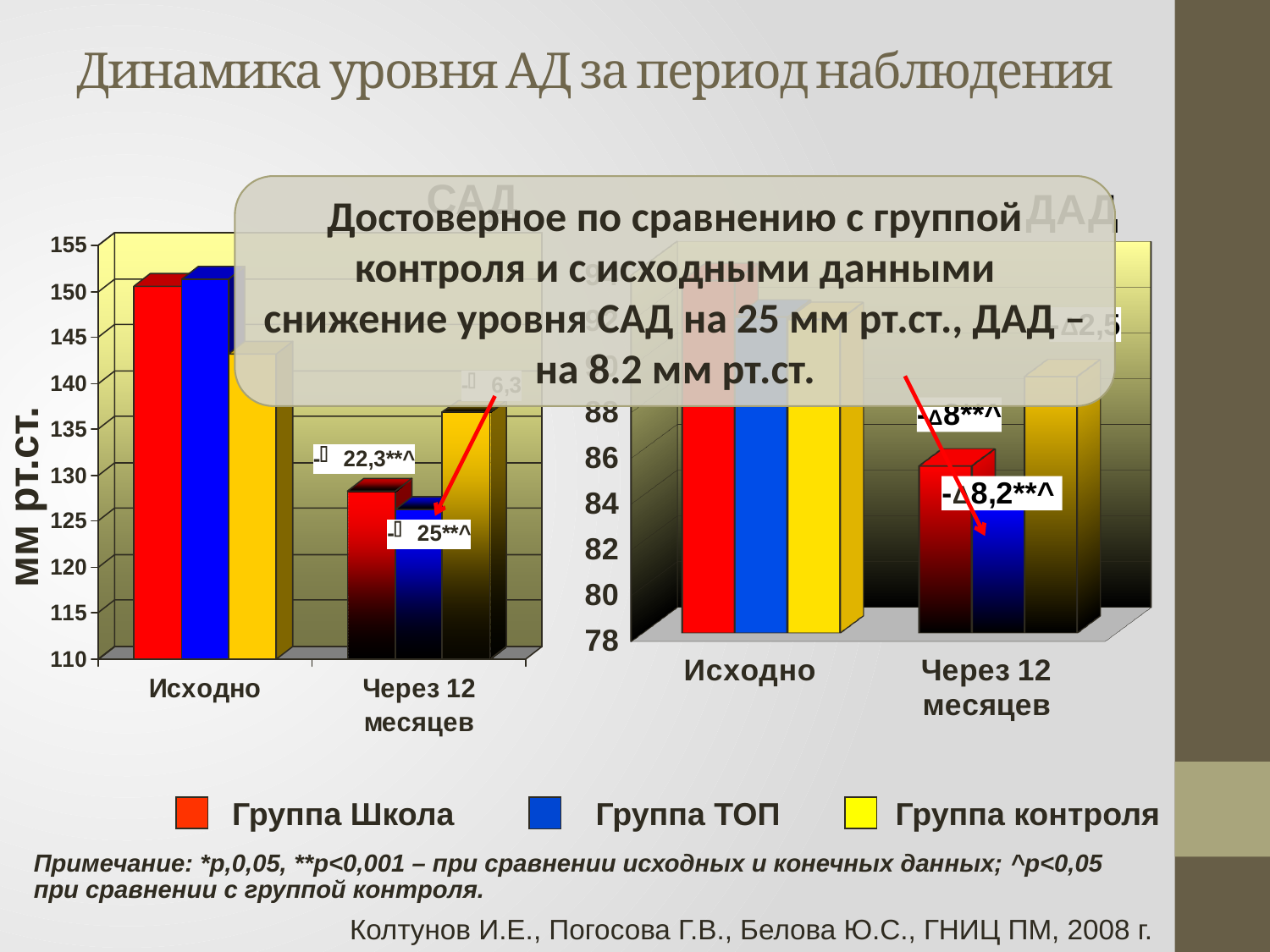
In the left chart (САД), does the value for Группа Школа rise or fall from Исходно to Через 12 месяцев? fall In the right chart (ДАД), is the value for Группа ТОП at Через 12 месяцев greater or less than 86? less How many series does the legend list? 3 In the left chart (САД), is the value for Группа Школа at Исходно greater or less than 145? greater In the left chart (САД), at Через 12 месяцев, which is larger: Группа контроля or Группа ТОП? Группа контроля What type of chart is the left chart (САД)? bar chart In the left chart (САД), is the value for Группа контроля at Через 12 месяцев greater or less than 130? greater What is the y-axis label of the left chart (САД)? мм рт.ст. How many categories are shown on the x axis of the right chart (ДАД)? 2 In the right chart (ДАД), at Через 12 месяцев, which is larger: Группа контроля or Группа Школа? Группа контроля